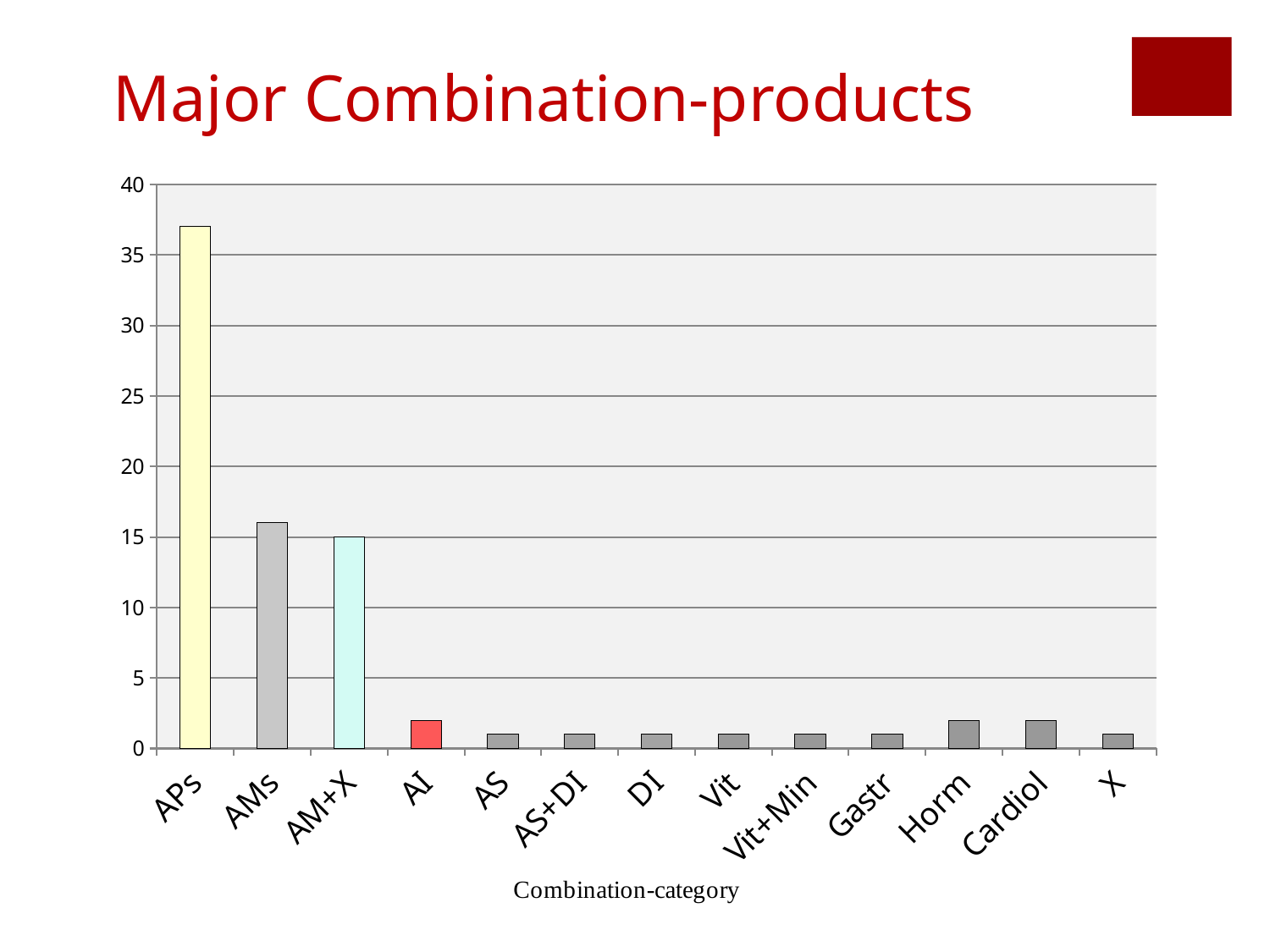
What kind of chart is shown on the slide? bar chart Is the value for AM+X greater or less than 10? greater Is the value for AI greater or less than 5? less How many combination categories are plotted on the x axis? 13 What is the label of the x axis? Combination-category What is the title of the slide containing the chart? Major Combination-products Which has the larger value, APs or AMs? APs Do the values generally rise or fall moving from left to right along the x axis? fall Is the value for AMs greater or less than 20? less Which combination category has the highest value? APs Which has the larger value, AI or AS? AI